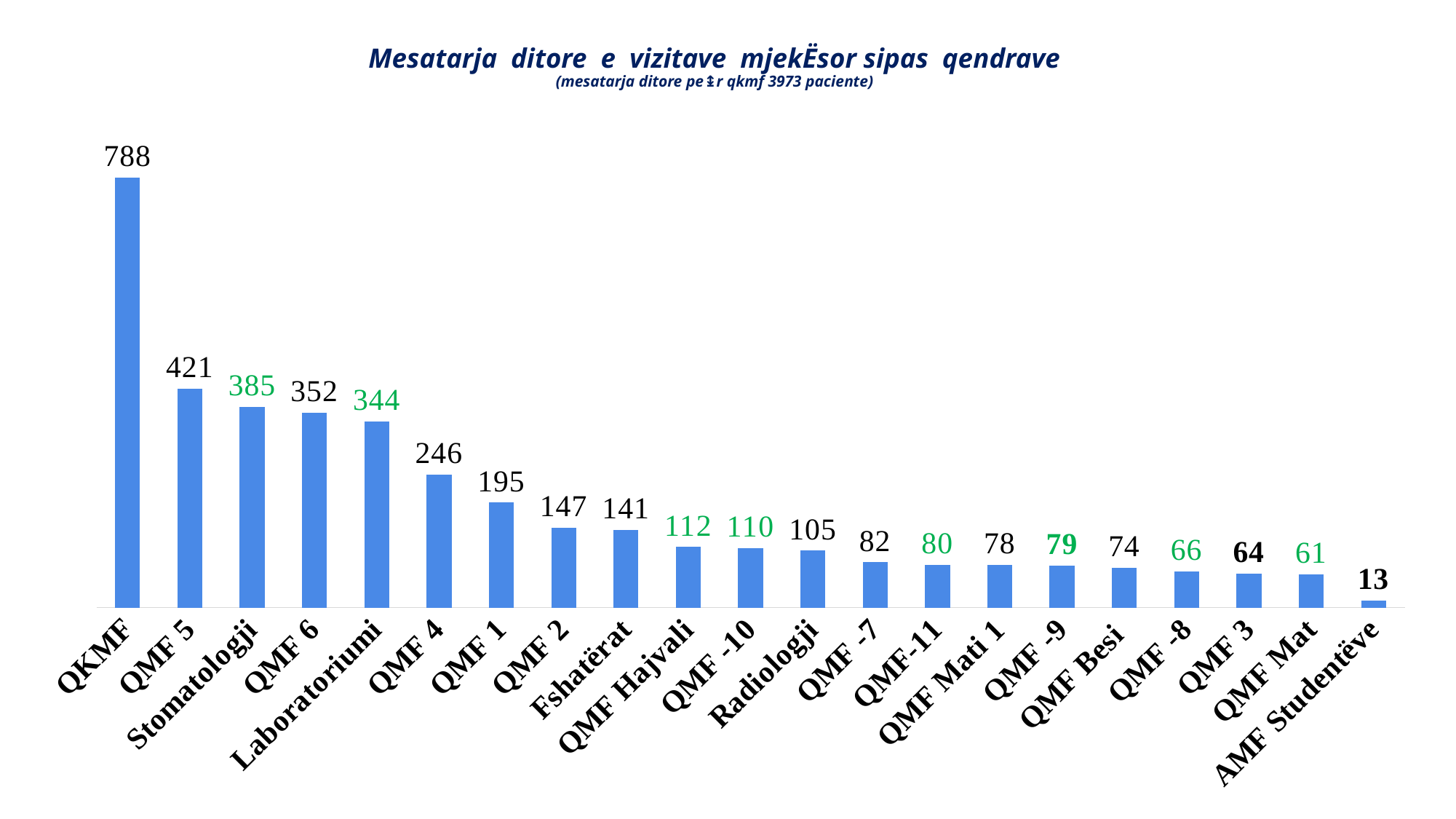
What is the difference between the values for Stomatologji and QMF 6? 33 Which is larger, the value for QMF 4 or the value for QMF 1? QMF 4 Which category has the lowest value? AMF Studentëve What kind of chart is shown on the slide? Bar chart What is the value for QMF Hajvali? 112 How many categories are shown in the chart? 21 What is the value for Laboratoriumi? 344 What is the difference between the values for QKMF and QMF 5? 367 What is the value for AMF Studentëve? 13 Do the values rise or fall from left to right across the chart? Fall What is the value for QKMF? 788 Which category has the highest value? QKMF